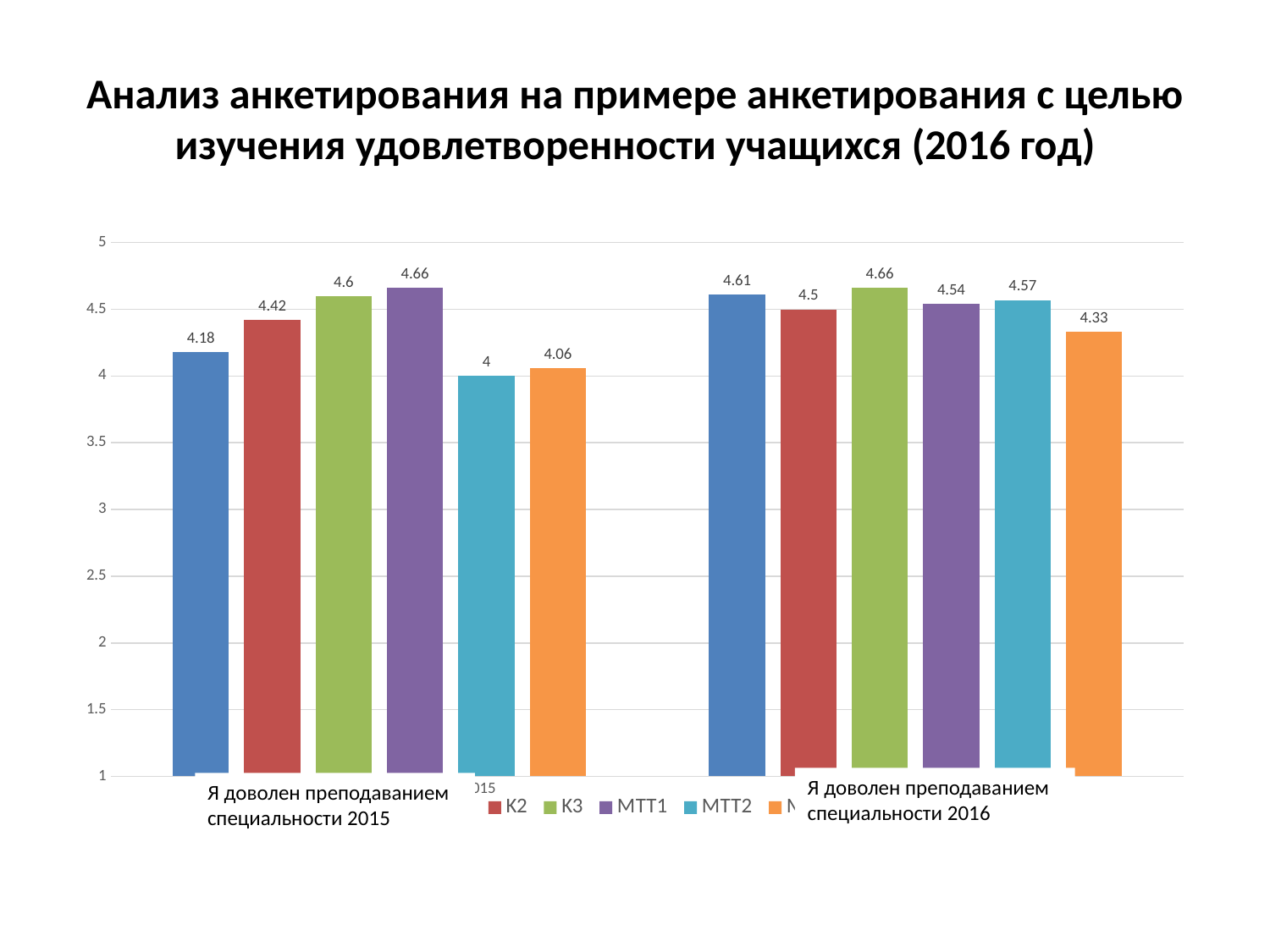
In the 2015 group, which is larger: К3 or МТТ1? МТТ1 What is the value of К3 for "Я доволен преподаванием специальности 2016"? 4.66 For МТТ2, which group has the larger value: 2015 or 2016? 2016 What kind of chart is shown on the slide? Bar chart What is the value of МТТ1 for "Я доволен преподаванием специальности 2016"? 4.54 Which series has the lowest value in the "Я доволен преподаванием специальности 2015" group? МТТ2 What is the value of К2 for "Я доволен преподаванием специальности 2015"? 4.42 What is the value of МТТ2 for "Я доволен преподаванием специальности 2015"? 4 By how much does the К2 value for 2016 exceed the К2 value for 2015? 0.08 How many category groups are shown on the x axis? 2 Which series has the highest value in the "Я доволен преподаванием специальности 2015" group? МТТ1 Does the К3 value rise or fall from the 2015 group to the 2016 group? Rise